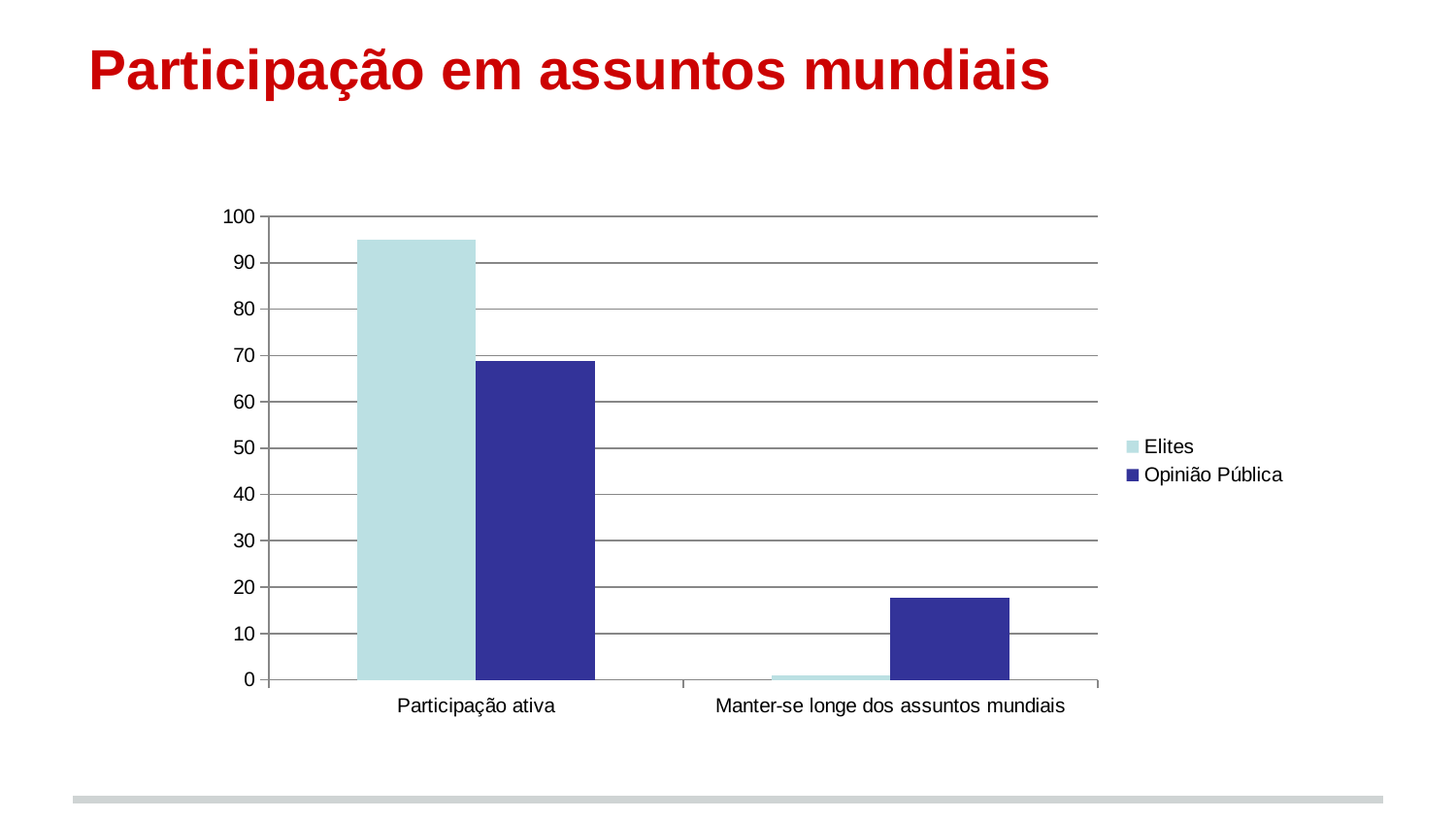
How many series does the legend list? 2 Is the value for Opinião Pública in Manter-se longe dos assuntos mundiais greater or less than 20? less Is the value for Elites in Participação ativa greater or less than 90? greater Is the value for Opinião Pública in Participação ativa greater or less than 60? greater Which series does the legend list first? Elites Which category has the highest value for the Elites series? Participação ativa How many categories are shown on the x axis? 2 Which is larger for Participação ativa: Elites or Opinião Pública? Elites What kind of chart is shown on the slide? bar chart Which is larger for Manter-se longe dos assuntos mundiais: Elites or Opinião Pública? Opinião Pública What is the title of the slide? Participação em assuntos mundiais